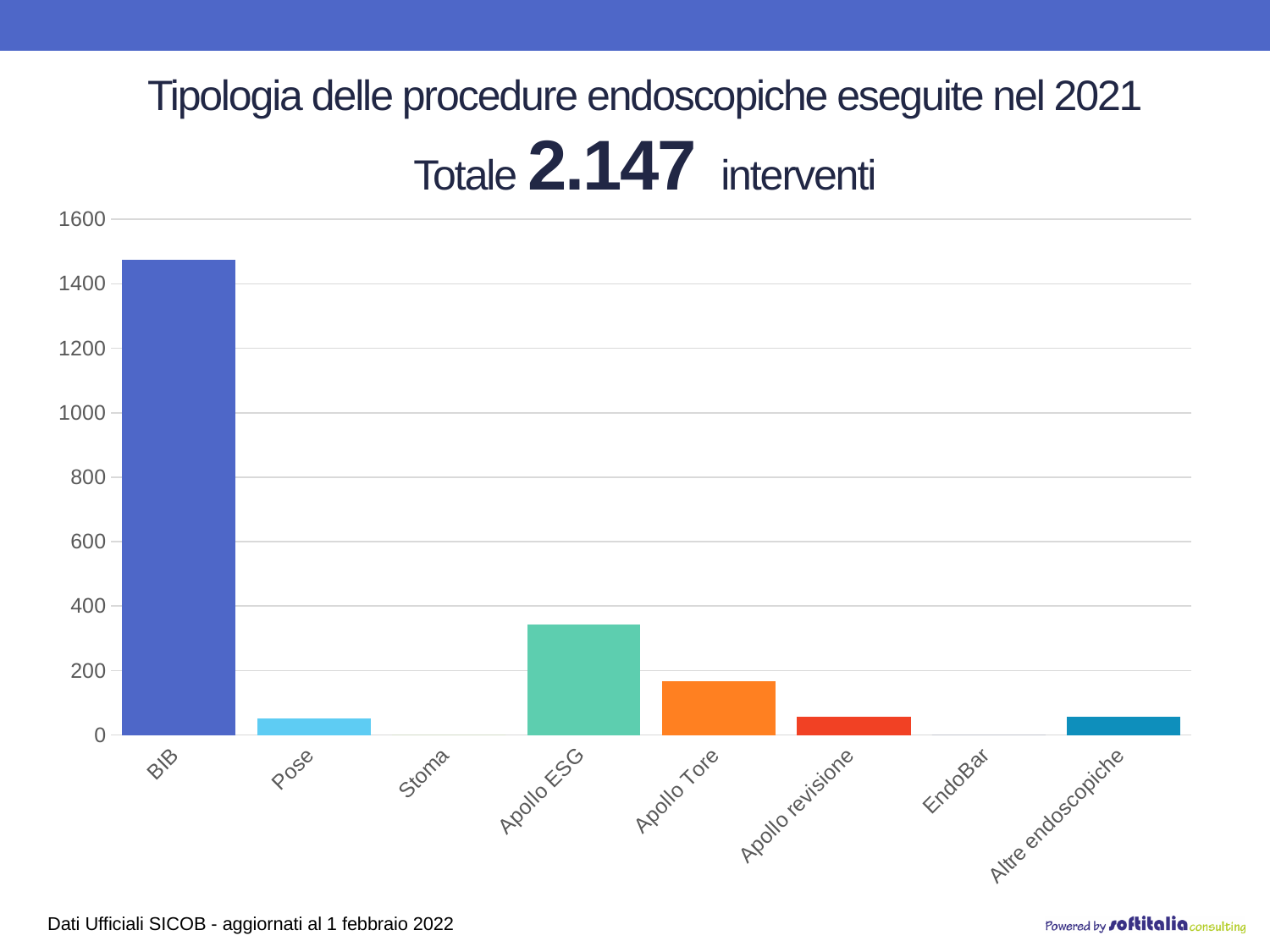
How many categories are shown on the x axis of the chart? 8 Is the value for Apollo ESG greater or less than 200? greater Is the value for Pose greater or less than 200? less Which is larger, the value for Apollo ESG or the value for Apollo Tore? Apollo ESG Is the value for BIB greater or less than 1400? greater Which is larger, the value for Apollo Tore or the value for Pose? Apollo Tore What total number of interventions is stated in the chart title? 2.147 What is the title of the chart? Tipologia delle procedure endoscopiche eseguite nel 2021 What kind of chart is shown on the slide? bar chart Which category has the highest value in the chart? BIB